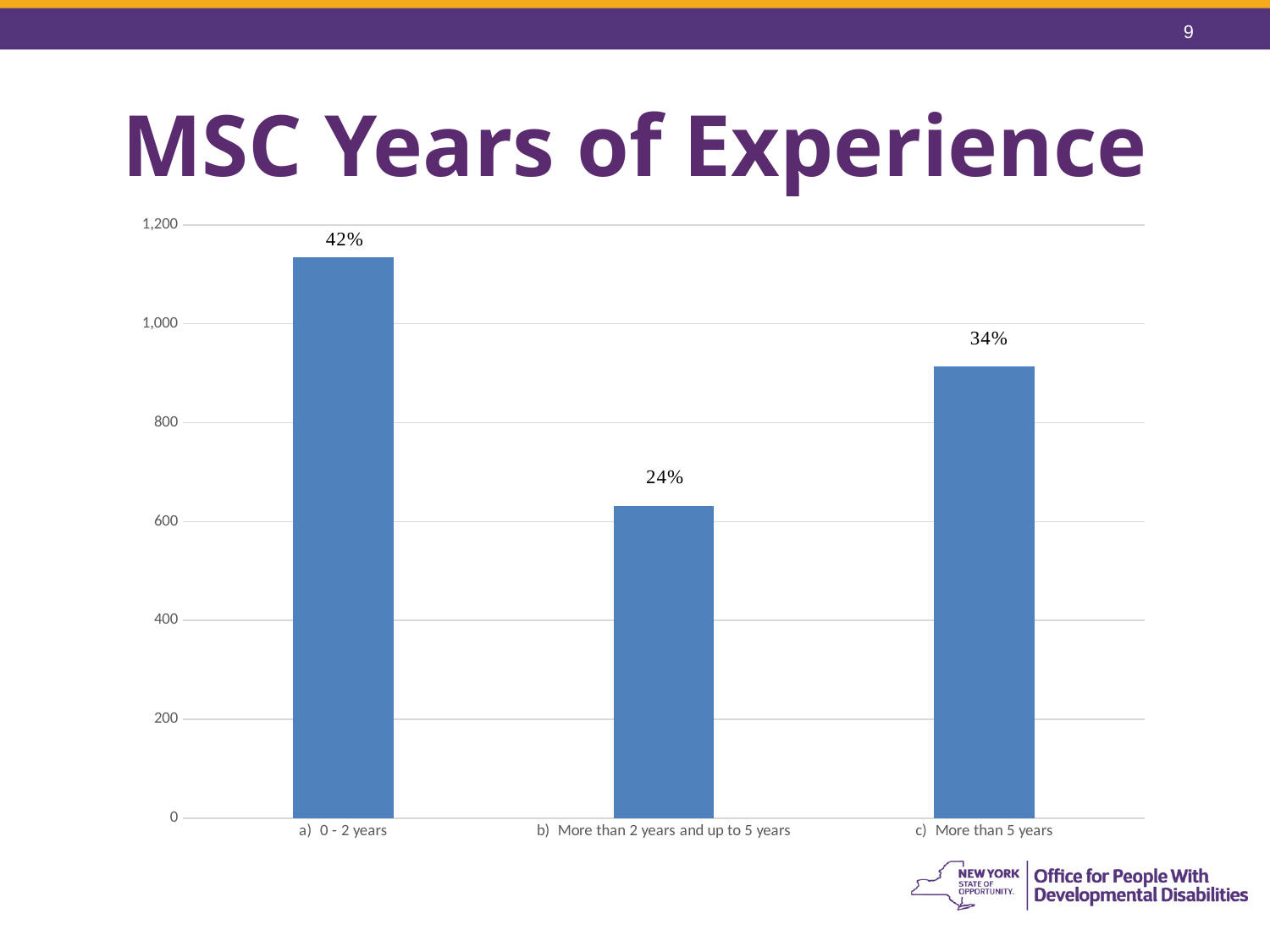
What percentage label is shown on the bar for "c) More than 5 years"? 34% What is the difference in percentage points between the labels for "a) 0 - 2 years" and "b) More than 2 years and up to 5 years"? 18 Which years-of-experience category has the tallest bar? a) 0 - 2 years Is the value for "b) More than 2 years and up to 5 years" greater or less than 800? less What percentage label is shown on the bar for "b) More than 2 years and up to 5 years"? 24% What percentage label is shown on the bar for "a) 0 - 2 years"? 42% Which years-of-experience category has the shortest bar? b) More than 2 years and up to 5 years Is the value for "c) More than 5 years" greater or less than 800? greater How many categories are shown on the x axis of the chart? 3 What type of chart is shown on the slide? Bar chart Is the value for "a) 0 - 2 years" greater or less than 1,000? greater Which bar is taller: "c) More than 5 years" or "b) More than 2 years and up to 5 years"? c) More than 5 years